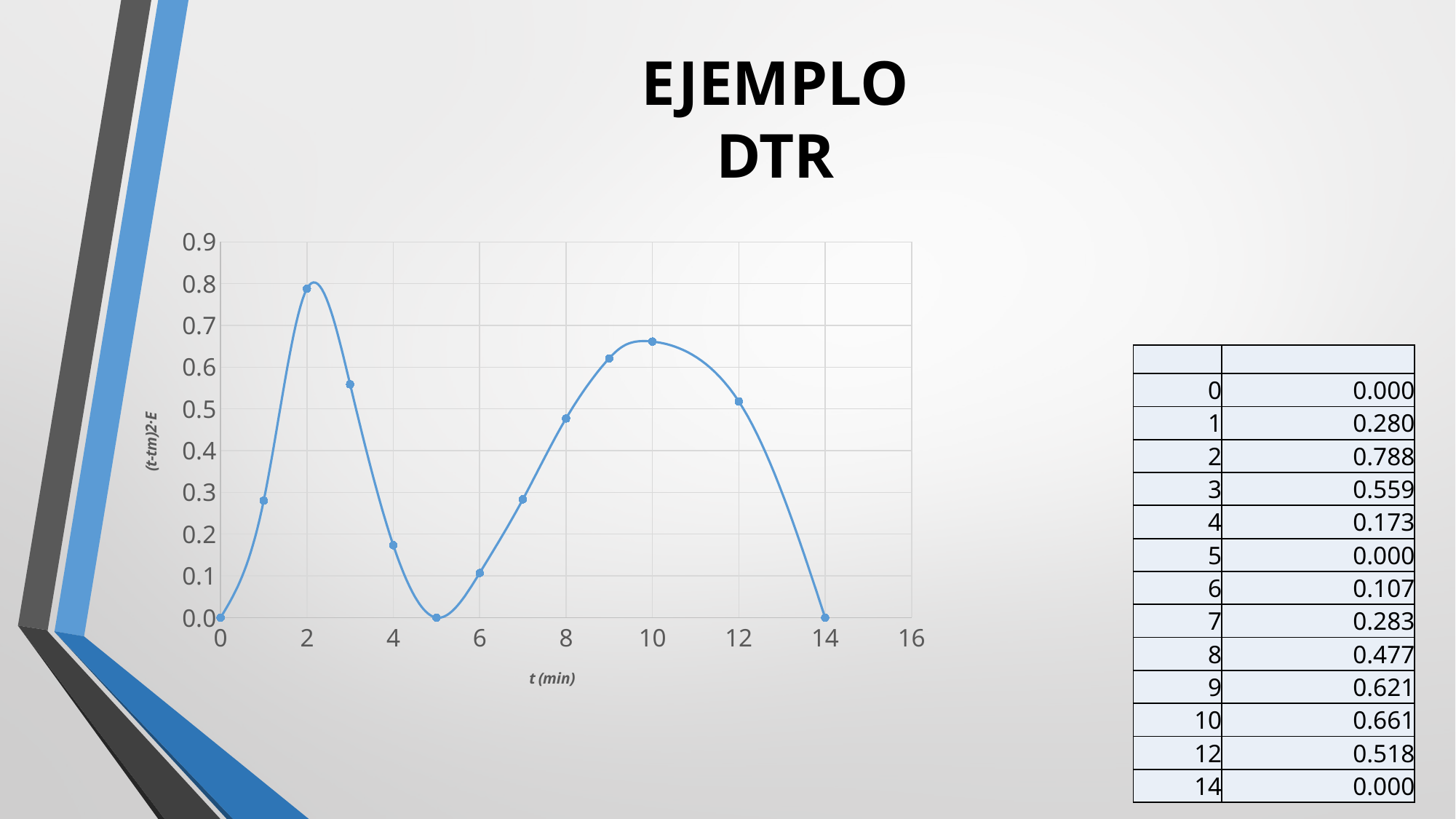
What is the value plotted at t = 2 min? 0.788 At which value of t does the curve reach its highest point? 2 What is the lowest value plotted on the chart? 0.000 What kind of chart is shown on the slide? line chart What is the value plotted at t = 10 min? 0.661 What is the label of the x axis? t (min) What is the value plotted at t = 8 min? 0.477 How many data points are plotted on the chart? 13 Is the value at t = 4 greater or less than 0.2? less Which is larger, the value at t = 3 or the value at t = 12? t = 3 Do the values rise or fall as t goes from 5 to 10 min? rise What is the difference between the values at t = 2 and t = 10? 0.127